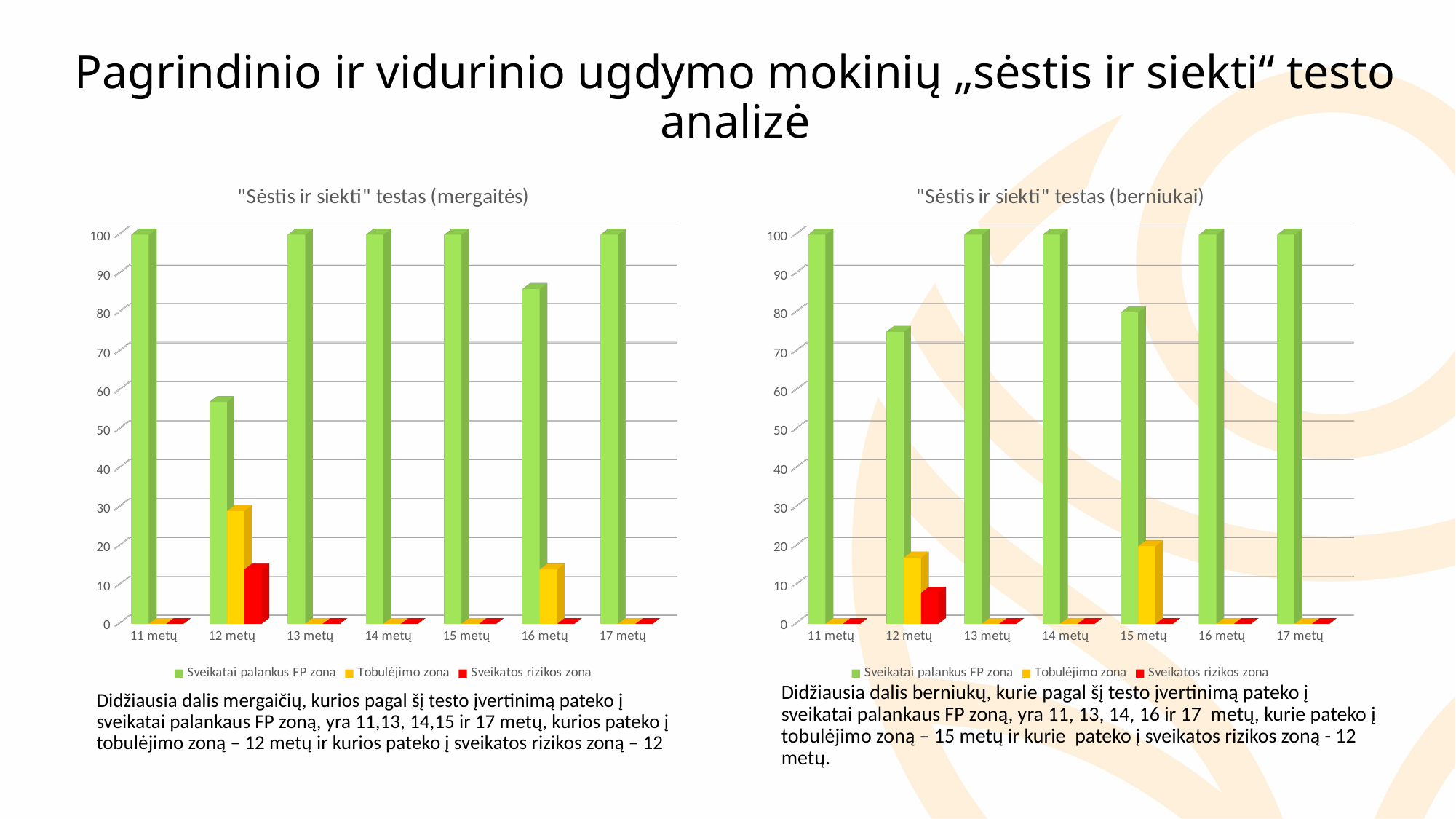
Which colour represents Sveikatos rizikos zona in the legend of the "Sėstis ir siekti" testas (berniukai) chart? red In the "Sėstis ir siekti" testas (mergaitės) chart, is the Sveikatai palankus FP zona value for 12 metų greater or less than 60? less In the "Sėstis ir siekti" testas (berniukai) chart, which is larger for 12 metų: Tobulėjimo zona or Sveikatos rizikos zona? Tobulėjimo zona How many series does the legend of the "Sėstis ir siekti" testas (mergaitės) chart list? 3 In the "Sėstis ir siekti" testas (berniukai) chart, is the Sveikatai palankus FP zona value for 15 metų greater or less than 70? greater In the "Sėstis ir siekti" testas (mergaitės) chart, what is the value of Sveikatai palankus FP zona for 13 metų? 100 In the "Sėstis ir siekti" testas (mergaitės) chart, which age category has the lowest Sveikatai palankus FP zona value? 12 metų What kind of chart is the "Sėstis ir siekti" testas (mergaitės) chart? bar chart How many age categories are shown on the x axis of the "Sėstis ir siekti" testas (berniukai) chart? 7 In the "Sėstis ir siekti" testas (mergaitės) chart, is the Sveikatai palankus FP zona value for 16 metų greater or less than 80? greater In the "Sėstis ir siekti" testas (berniukai) chart, which age category has the lowest Sveikatai palankus FP zona value? 12 metų In the "Sėstis ir siekti" testas (berniukai) chart, what is the value of Sveikatai palankus FP zona for 16 metų? 100